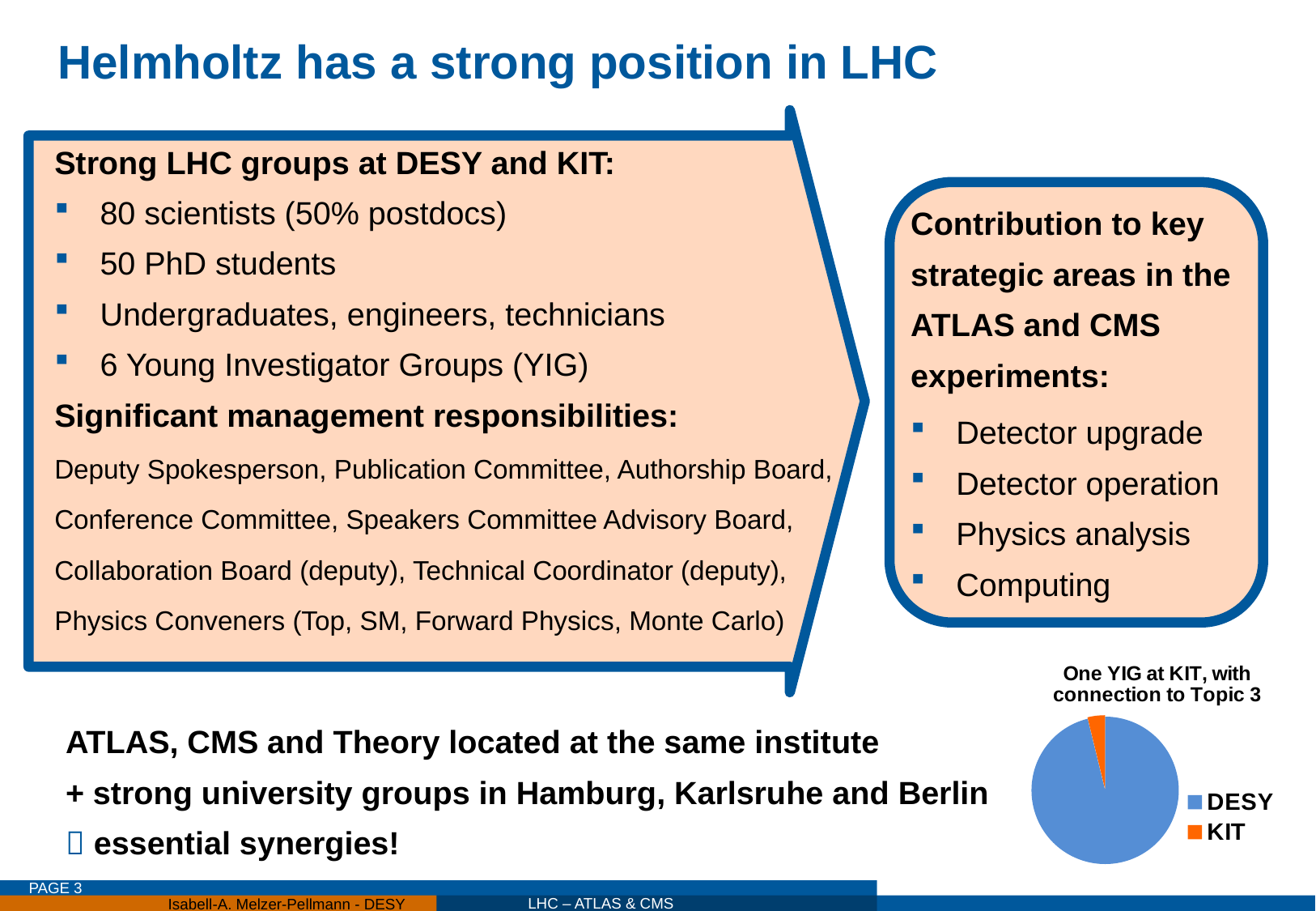
In the pie chart, which slice is larger, DESY or KIT? DESY How many slices does the pie chart have? 2 Which category has the largest slice in the pie chart? DESY What colour is the DESY slice in the pie chart? blue Which category has the smallest slice in the pie chart? KIT What colour is the KIT slice in the pie chart? orange How many entries does the legend of the pie chart list? 2 What kind of chart is shown at the bottom right of the slide? pie chart